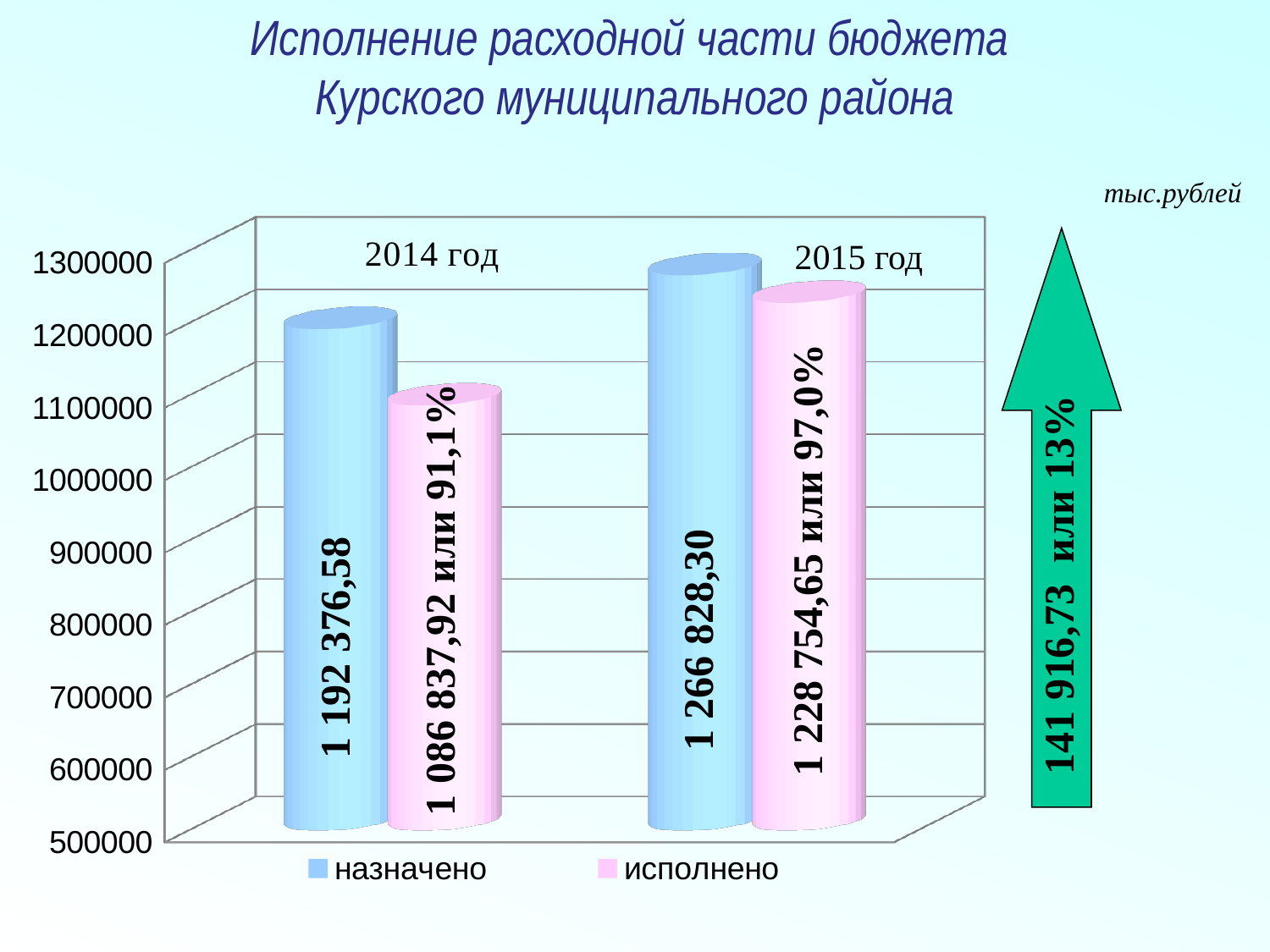
What execution percentage is shown on the исполнено bar for 2014 год? 91,1% What is the value of the исполнено bar for 2015 год? 1 228 754,65 What is the difference between the назначено and исполнено values for 2014 год? 105 538,66 What is the value of the назначено bar for 2014 год? 1 192 376,58 Which bar on the chart has the highest value? назначено, 2015 год What unit of measurement is indicated for the chart values? тыс.рублей How many series does the legend list? 2 Which bar on the chart has the lowest value? исполнено, 2014 год What is the difference between the исполнено values for 2015 год and 2014 год? 141 916,73 What execution percentage is shown on the исполнено bar for 2015 год? 97,0% What kind of chart is shown on the slide? bar chart Which is larger: the назначено value for 2014 год or the исполнено value for 2015 год? исполнено for 2015 год